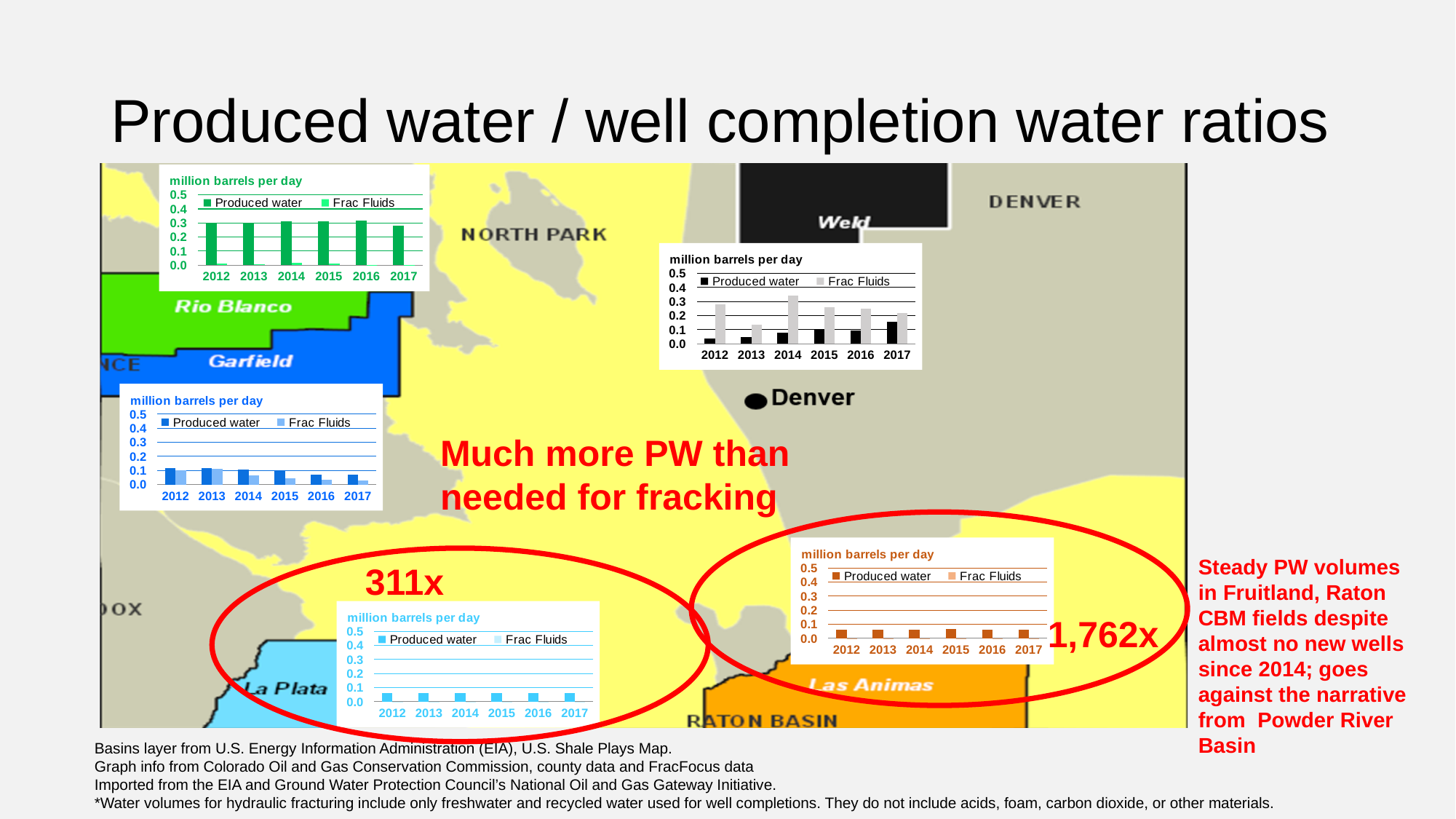
In the chart at the top left of the slide (green bars), is the Frac Fluids value for 2014 greater or less than 0.1? less In the chart at the top left of the slide (green bars), how many series does the legend list? 2 In the chart at the top left of the slide (green bars), what are the two legend entries? Produced water, Frac Fluids In the chart near the top right of the slide (black and gray bars, near Weld), is the Frac Fluids value for 2014 greater or less than 0.3? greater How many years are shown on the x axis of the chart at the bottom left of the slide (light blue bars, near La Plata)? 6 What kind of chart is the chart at the bottom right of the slide (orange bars, near Las Animas)? bar chart In the chart near the top right of the slide (black and gray bars, near Weld), does the Produced water series rise or fall from 2012 to 2017? rise In the chart on the middle left of the slide (blue bars, below Garfield), does the Produced water series rise or fall from 2013 to 2017? fall In the chart near the top right of the slide (black and gray bars, near Weld), which is larger in 2012: Produced water or Frac Fluids? Frac Fluids In the chart near the top right of the slide (black and gray bars, near Weld), which year has the highest Frac Fluids value? 2014 In the chart at the top left of the slide (green bars), is the Produced water value for 2012 greater or less than 0.2? greater